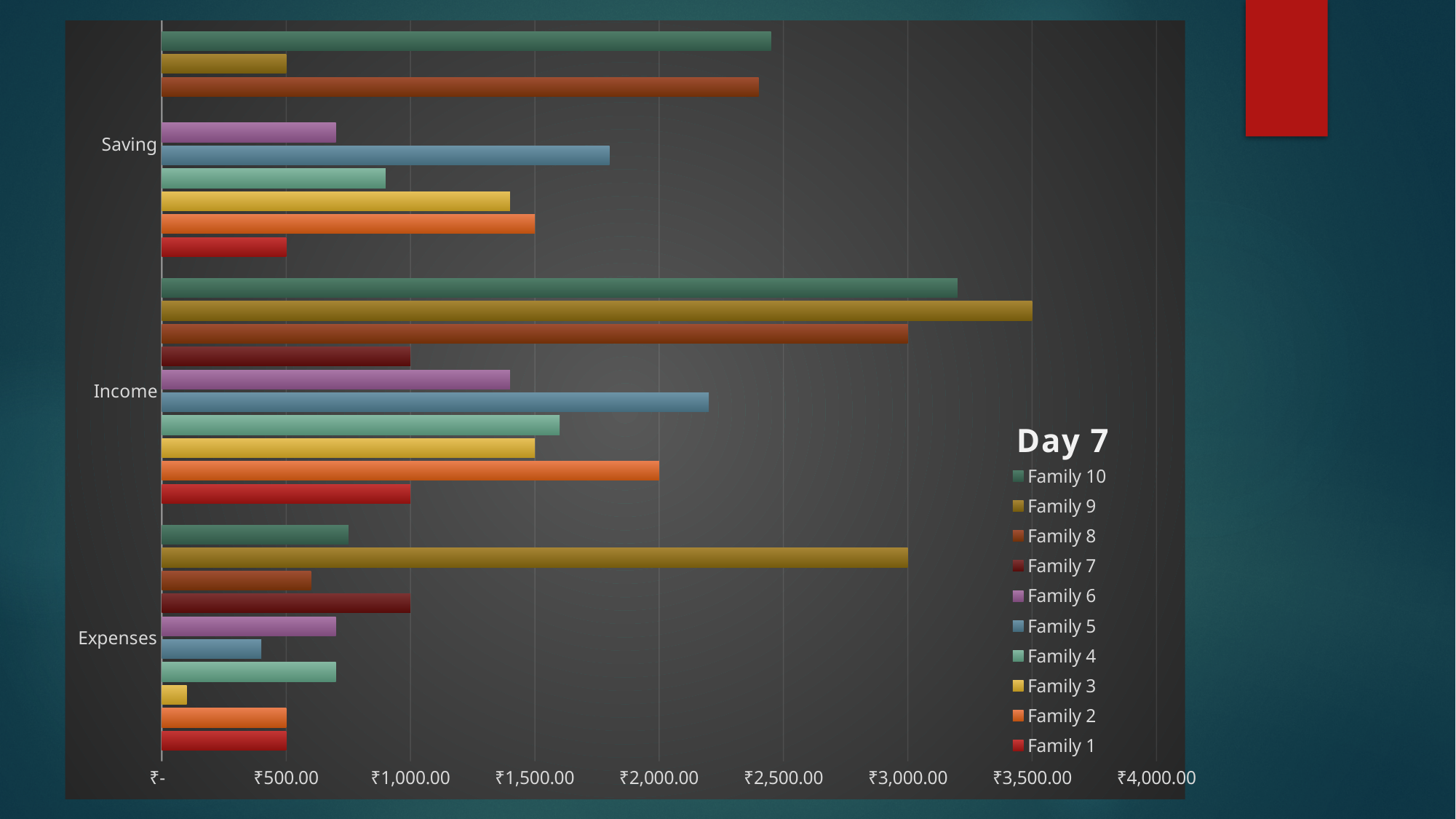
Which family has the highest Expenses? Family 9 Is the Saving value for Family 5 greater or less than ₹1,500.00? greater How many series does the legend list? 10 What is the title of the chart? Day 7 Is the Income value for Family 10 greater or less than ₹3,000.00? greater What kind of chart is shown on the slide? bar chart How many categories are shown on the vertical axis? 3 Which family has the lowest Expenses? Family 3 What is the Income value for Family 9? ₹3,500.00 Which is larger, the Income of Family 5 or the Income of Family 4? Family 5 Is the Expenses value for Family 3 greater or less than ₹500.00? less Which family has the highest Income? Family 9